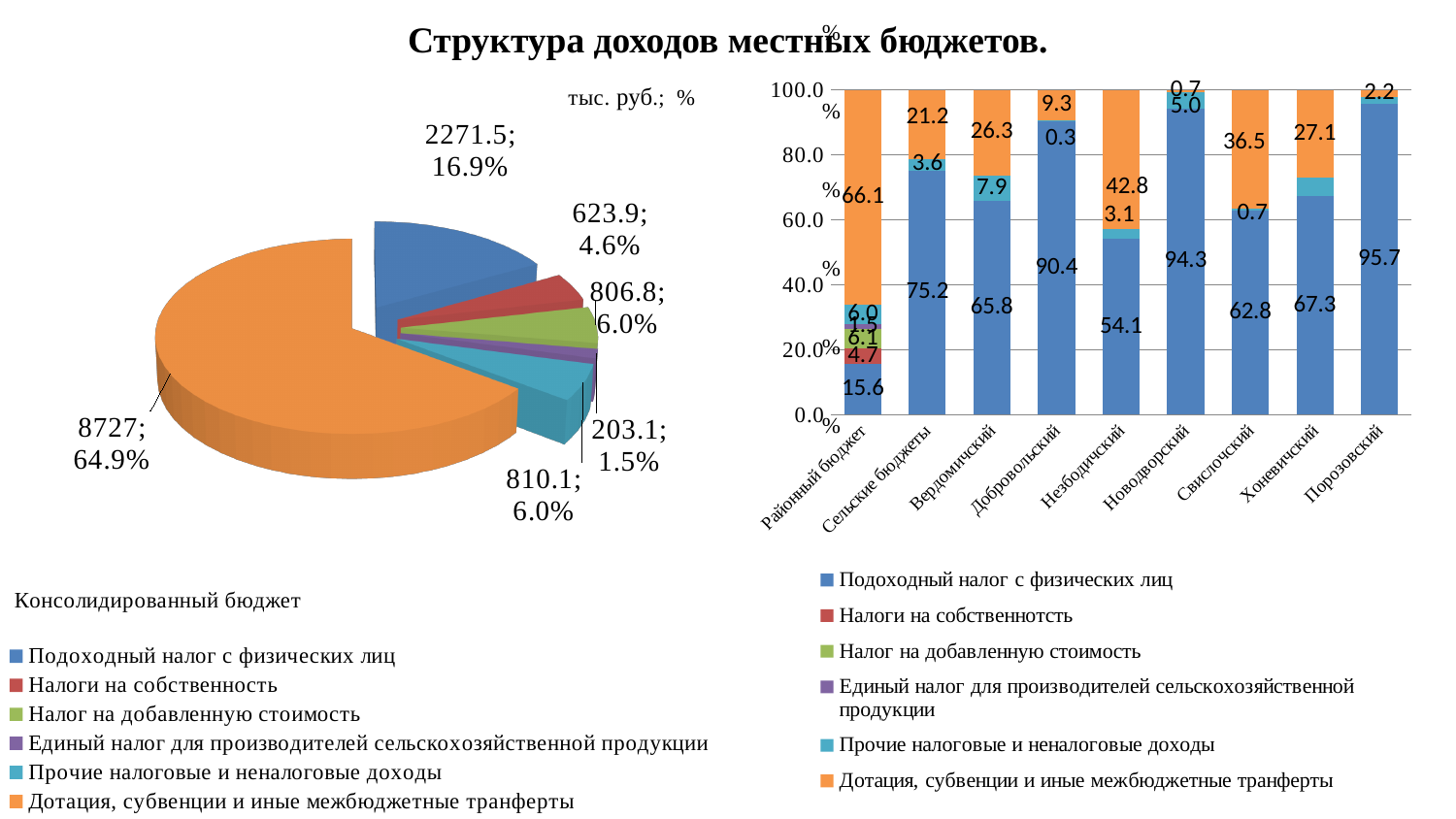
In the left pie chart, which category has the smallest slice? Единый налог для производителей сельскохозяйственной продукции In the right bar chart, which has the larger value for Подоходный налог с физических лиц: Добровольский or Новодворский? Новодворский How many categories are shown on the x axis of the right bar chart? 9 In the right bar chart, what is the value of Подоходный налог с физических лиц for Порозовский? 95.7 In the right bar chart, what is the difference between the Дотация values for Вердомичский and Сельские бюджеты? 5.1 What kind of chart is the right chart? bar chart How many series does the legend of the right bar chart list? 6 In the left pie chart, what share does Дотация, субвенции и иные межбюджетные трансферты have? 64.9% In the right bar chart, what is the value of Дотация, субвенции и иные межбюджетные трансферты for Незбодичский? 42.8 In the left pie chart, what value is shown for Подоходный налог с физических лиц? 2271.5; 16.9% In the left pie chart, which category has the largest slice? Дотация, субвенции и иные межбюджетные трансферты What kind of chart is the left chart (Консолидированный бюджет)? pie chart